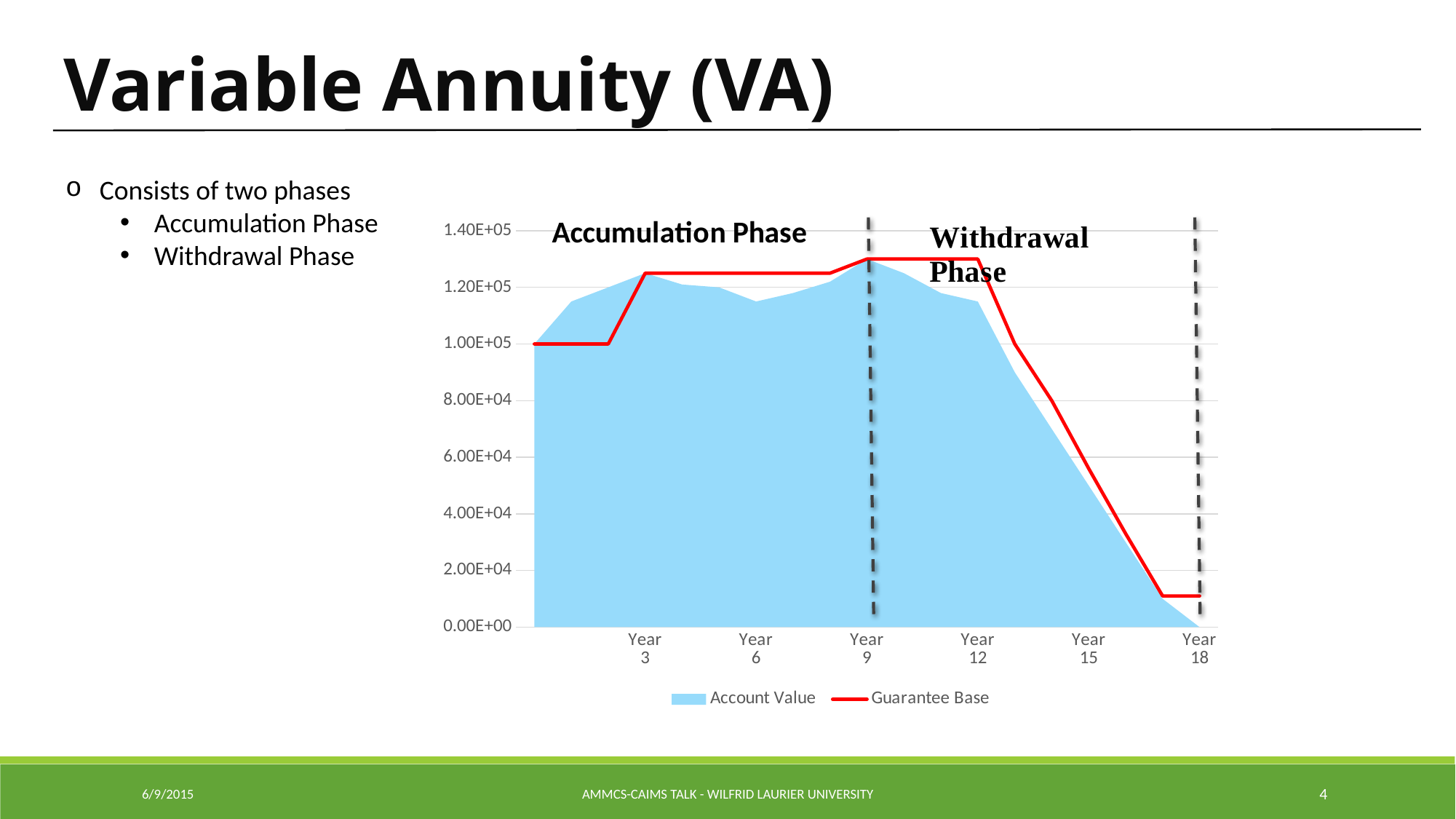
What is the Account Value at Year 18? 0.00E+00 Does the Account Value rise or fall between Year 12 and Year 18? Fall Is the Guarantee Base at Year 9 greater or less than 1.20E+05? greater How many series does the chart legend list? 2 Is the Account Value at Year 15 greater or less than 8.00E+04? less Which two phases are labelled on the chart? Accumulation Phase and Withdrawal Phase Is the Account Value at Year 12 greater or less than 1.00E+05? greater At Year 15, which is higher, the Account Value or the Guarantee Base? Guarantee Base What kind of chart is used to show the Account Value series? Area chart What is the Guarantee Base value at the start of the chart (before Year 3)? 1.00E+05 What are the two series named in the chart legend? Account Value and Guarantee Base How many year labels are shown on the x axis? 6